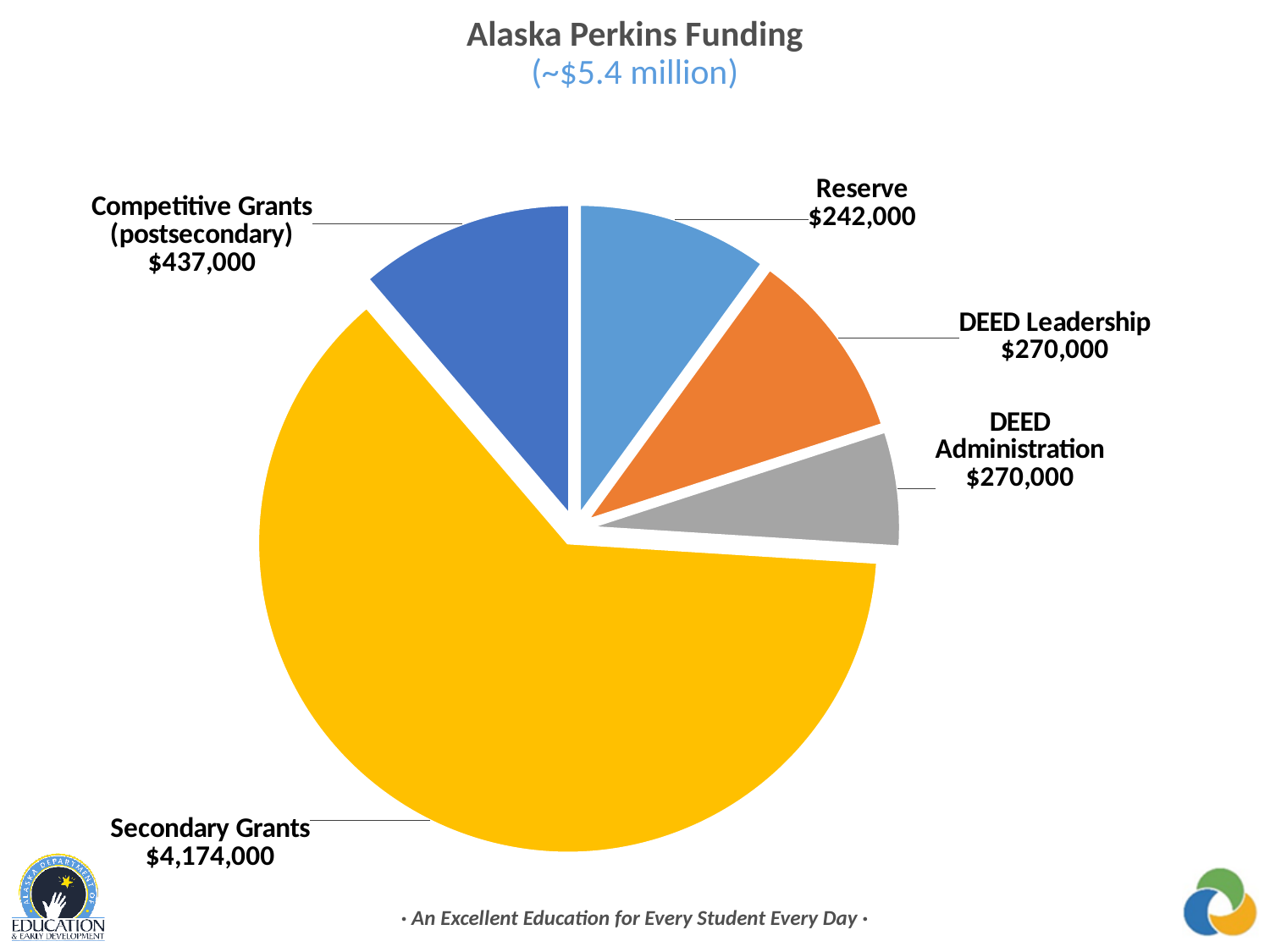
What is the value for Competitive Grants (postsecondary)? $437,000 How many slices does the pie chart have? 5 What is the title of the chart? Alaska Perkins Funding (~$5.4 million) What kind of chart is shown on the slide? Pie chart What is the value for Secondary Grants? $4,174,000 Which category has the smallest slice of the pie? DEED Administration What is the total of all the slices in the pie chart? $5,393,000 Which category has the largest slice of the pie? Secondary Grants What is the difference between Competitive Grants (postsecondary) and Reserve? $195,000 Which is larger, Competitive Grants (postsecondary) or Reserve? Competitive Grants (postsecondary) What is the value for DEED Leadership? $270,000 What is the value for Reserve? $242,000